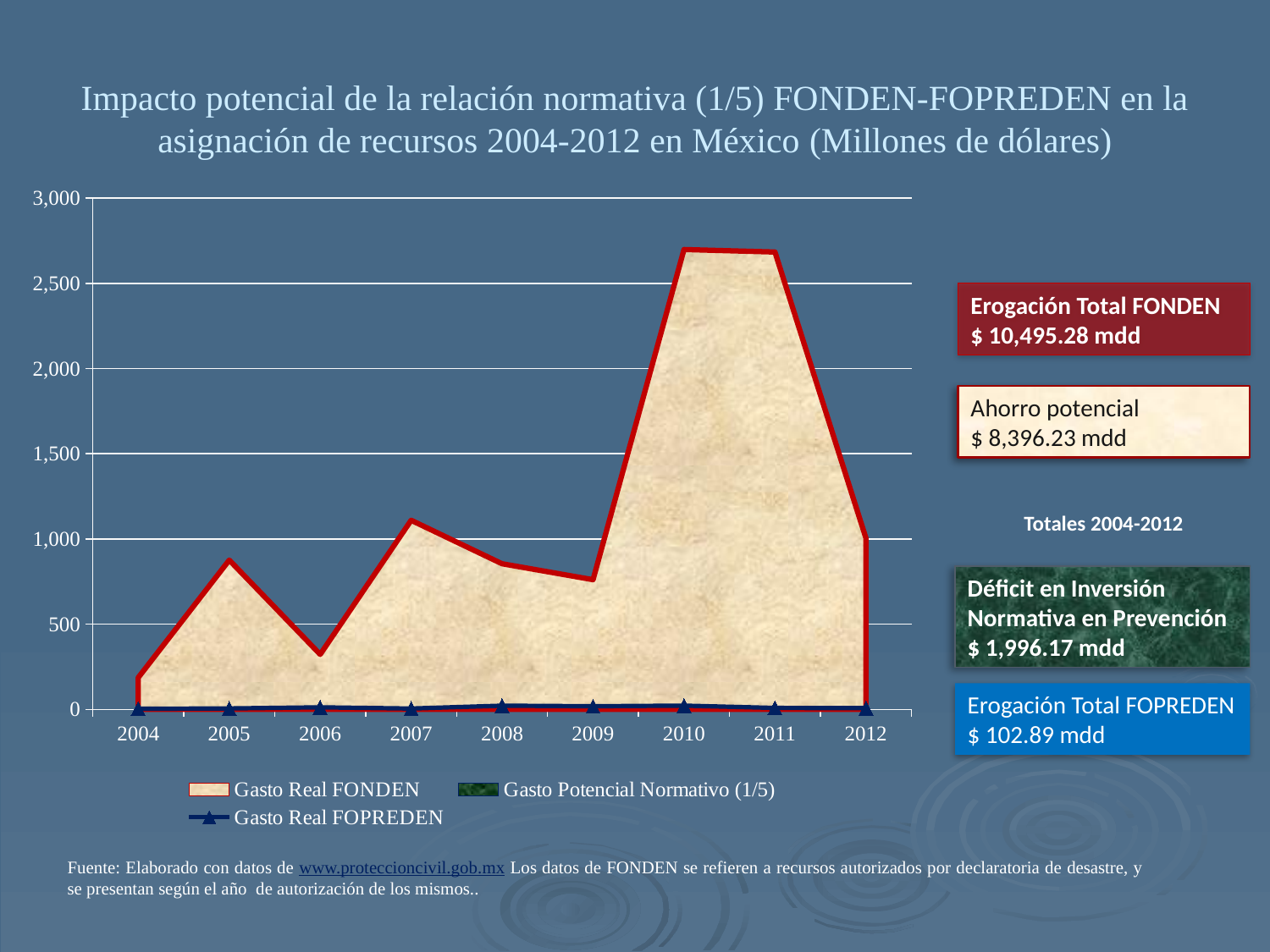
Is the value of Gasto Real FONDEN for 2007 greater or less than 1,000? greater Is the value of Gasto Real FONDEN for 2010 greater or less than 2,500? greater Is the value of Gasto Real FONDEN for 2006 greater or less than 500? less What kind of chart is shown on the slide? area chart Which year has a larger Gasto Real FONDEN value, 2005 or 2006? 2005 Which series in the legend is drawn as a line with triangle markers? Gasto Real FOPREDEN Does Gasto Real FONDEN rise or fall from 2011 to 2012? fall In which year is Gasto Real FONDEN lowest? 2004 How many years are shown on the x axis of the chart? 9 Which year has a larger Gasto Real FONDEN value, 2007 or 2008? 2007 How many series does the chart legend list? 3